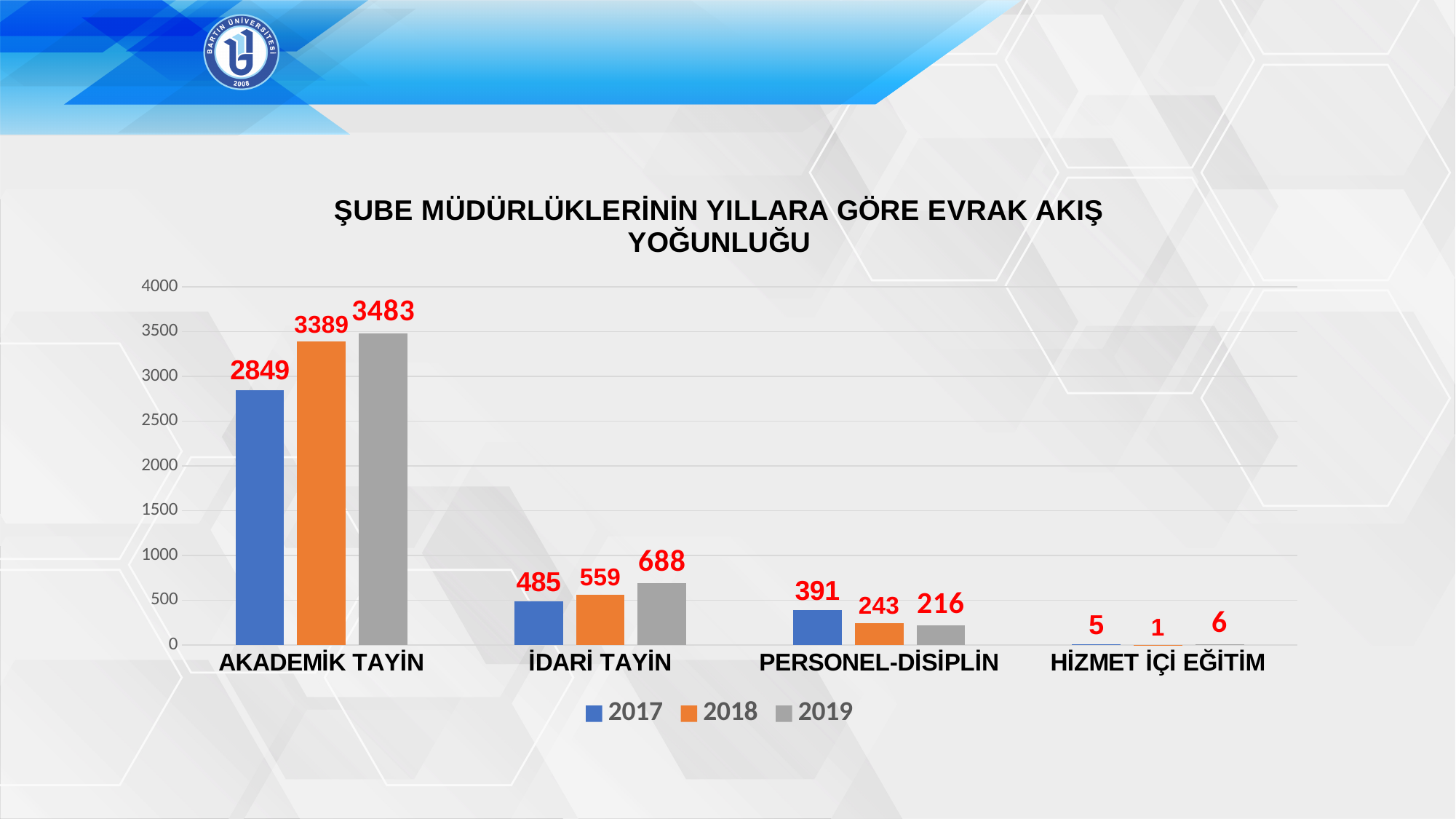
What is the value for AKADEMİK TAYİN in 2017? 2849 Which category has the highest value in 2019? AKADEMİK TAYİN Is the 2018 value for İDARİ TAYİN greater or less than 500? greater What is the value for PERSONEL-DİSİPLİN in 2018? 243 Which category has the lowest value in 2017? HİZMET İÇİ EĞİTİM What is the value for HİZMET İÇİ EĞİTİM in 2018? 1 Which is larger for PERSONEL-DİSİPLİN: the 2017 value or the 2019 value? 2017 What kind of chart is shown on the slide? Bar chart How many series does the legend list? 3 How many categories are shown on the x axis? 4 What is the value for İDARİ TAYİN in 2019? 688 What is the difference between the 2019 and 2018 values for AKADEMİK TAYİN? 94